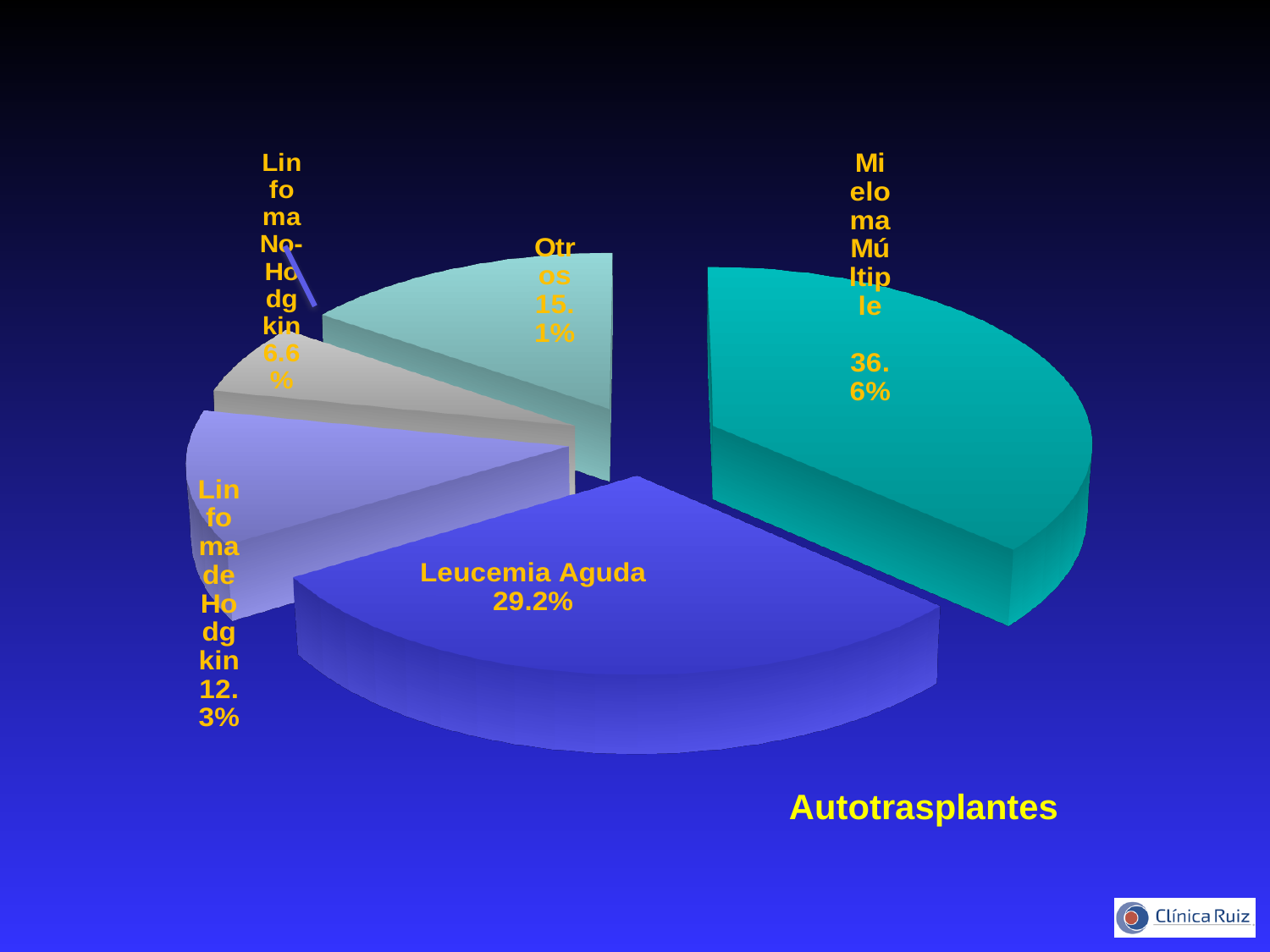
What is the title text shown below the pie chart? Autotrasplantes What percentage is shown for Linfoma de Hodgkin? 12.3% Which is larger, the share for Leucemia Aguda or the share for Otros? Leucemia Aguda What percentage of autotransplants corresponds to Mieloma Múltiple? 36.6% What percentage is shown for the Otros slice? 15.1% Which category has the largest share of the pie? Mieloma Múltiple What is the difference in percentage points between Mieloma Múltiple and Leucemia Aguda? 7.4 What kind of chart is shown on the slide? pie chart What percentage is shown for Leucemia Aguda? 29.2% How many slices does the pie chart have? 5 Which category has the smallest share of the pie? Linfoma No-Hodgkin What percentage is shown for Linfoma No-Hodgkin? 6.6%